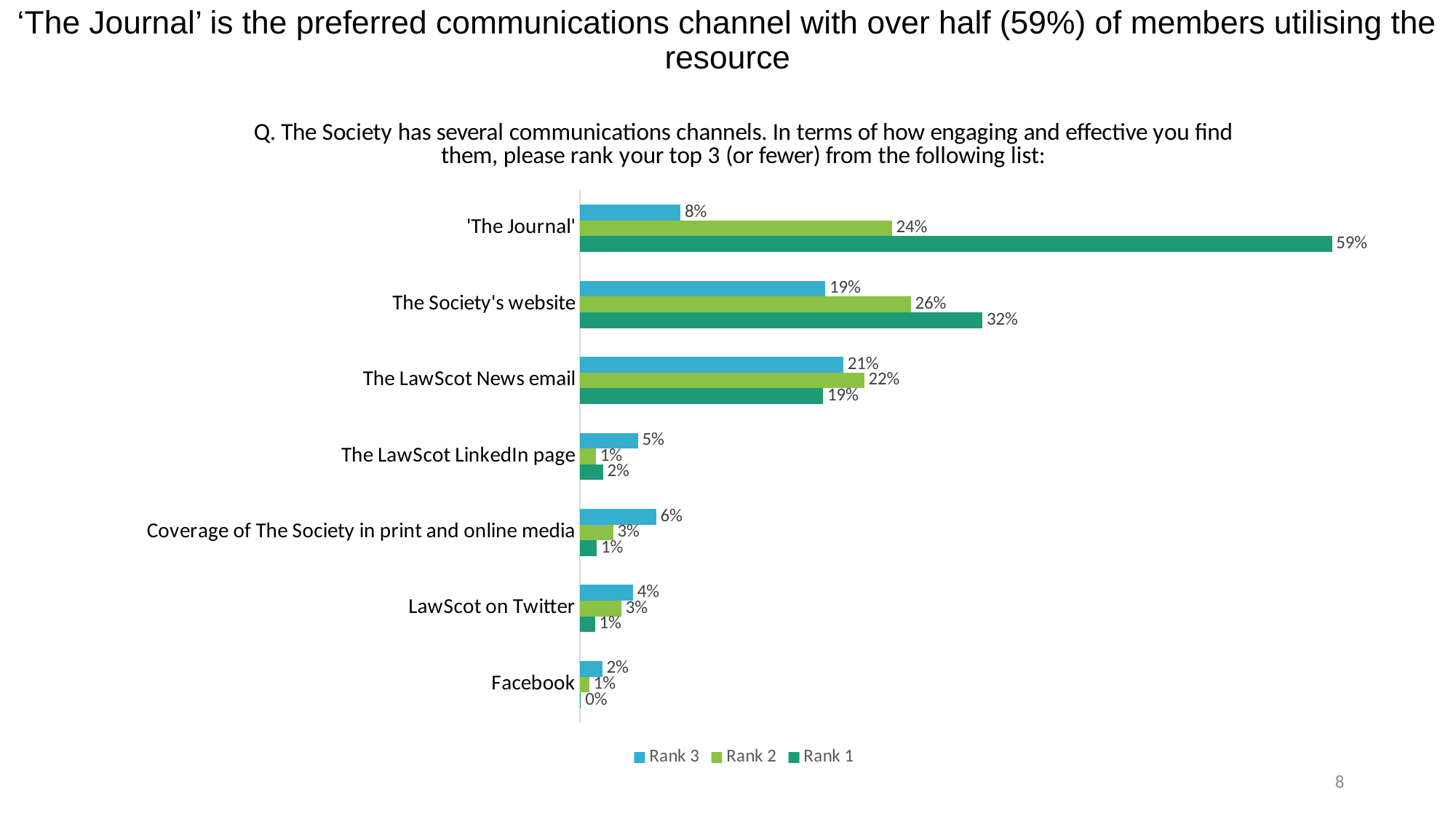
Which series is shown in dark green in the legend? Rank 1 Which category has the highest Rank 1 value? 'The Journal' What kind of chart is shown on the slide? Bar chart Which is larger: the Rank 3 value for The LawScot News email or the Rank 3 value for The Society's website? The LawScot News email What is the Rank 1 value for Facebook? 0% Which category has the lowest Rank 3 value? Facebook What is the difference between the Rank 1 values for 'The Journal' and The Society's website? 27% How many categories are shown on the chart? 7 What is the Rank 3 value for The LawScot News email? 21% What is the Rank 1 value for 'The Journal'? 59% How many series does the legend list? 3 What is the Rank 2 value for The Society's website? 26%